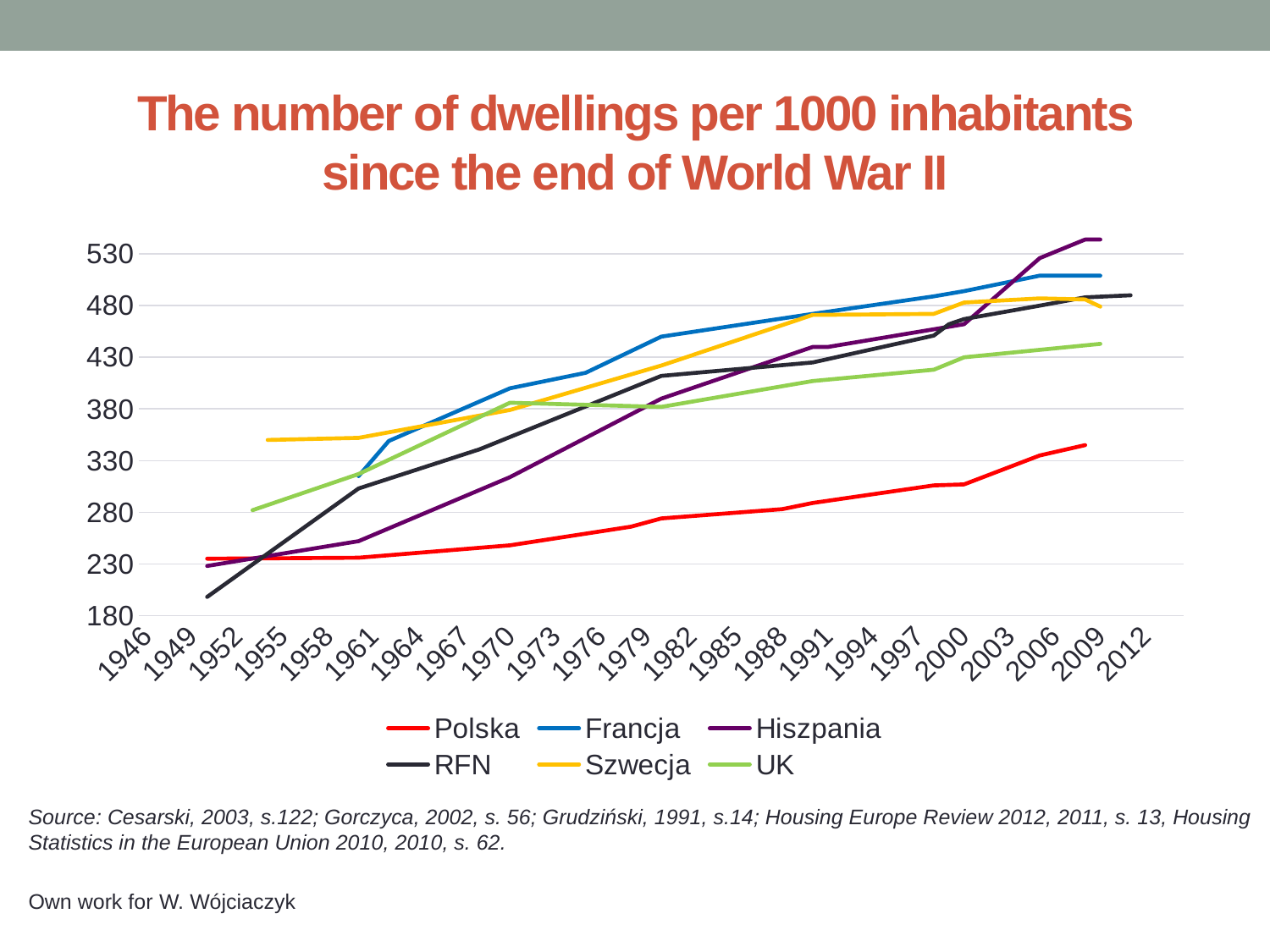
Is the value for Polska in 2009 greater or less than 380? less Which series has the highest value at the right end of the chart (2009)? Hiszpania What is the title of the chart? The number of dwellings per 1000 inhabitants since the end of World War II Is the value for RFN in 1949 greater or less than 230? less Is the value for Hiszpania in 2009 greater or less than 530? greater How many year labels are shown on the x axis? 23 Does the value for Polska rise or fall from 1946 to 2009? rise What kind of chart is shown on the slide? line chart Which series has the lowest values across the whole period? Polska How many series does the legend list? 6